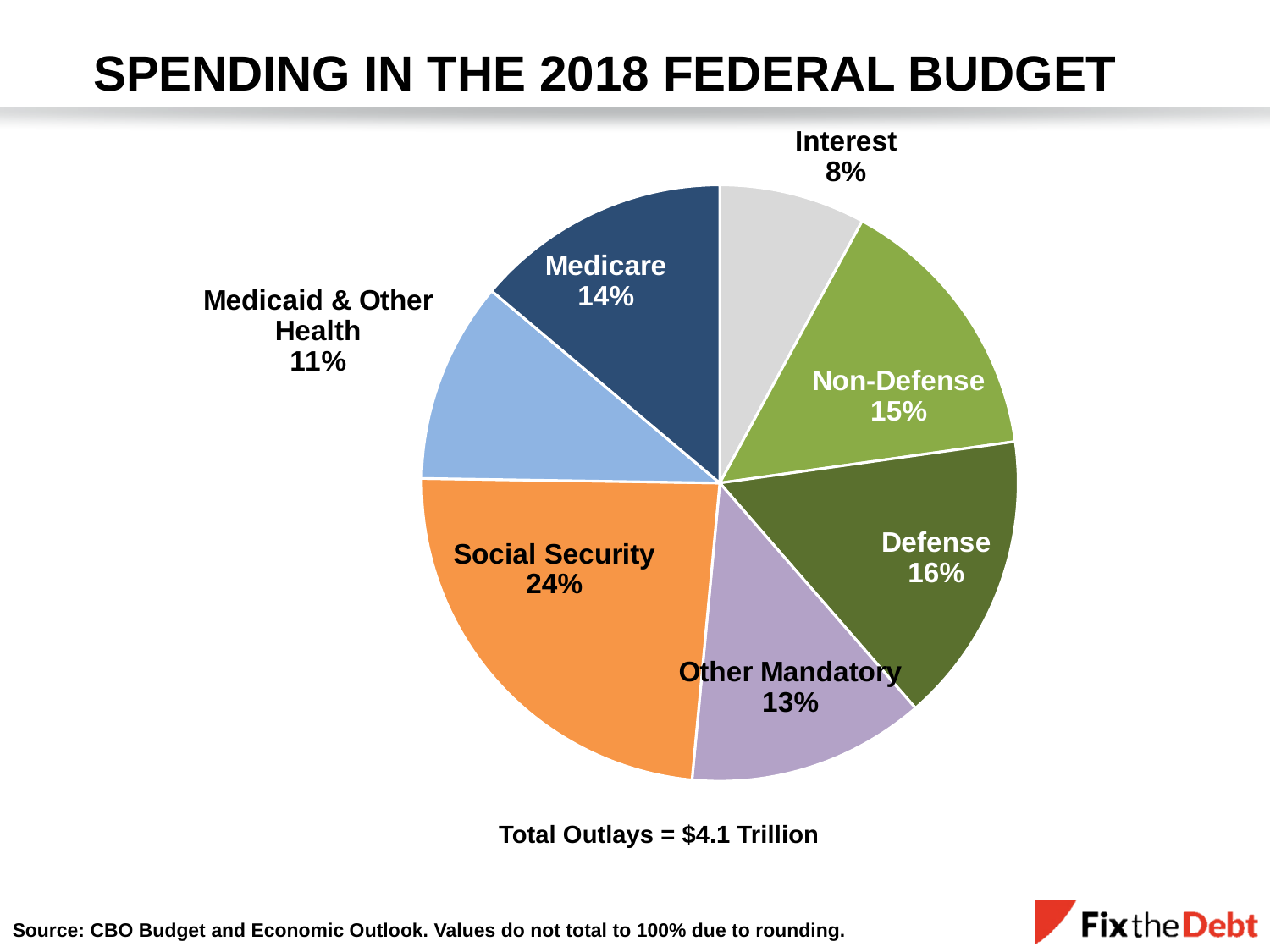
What percentage of spending is labelled for Defense? 16% How many categories are shown in the pie chart? 7 What total outlays figure is stated below the chart? $4.1 Trillion What share of the 2018 federal budget goes to Social Security? 24% Which is larger, Non-Defense or Other Mandatory? Non-Defense Which category has the smallest slice of the pie? Interest What is the difference in percentage points between Defense and Interest? 8 What kind of chart is shown on the slide? Pie chart What is the difference in percentage points between Social Security and Medicare? 10 Which category has the largest slice of the pie? Social Security What is the title of the chart? Spending in the 2018 Federal Budget What is the value shown for Medicaid & Other Health? 11%